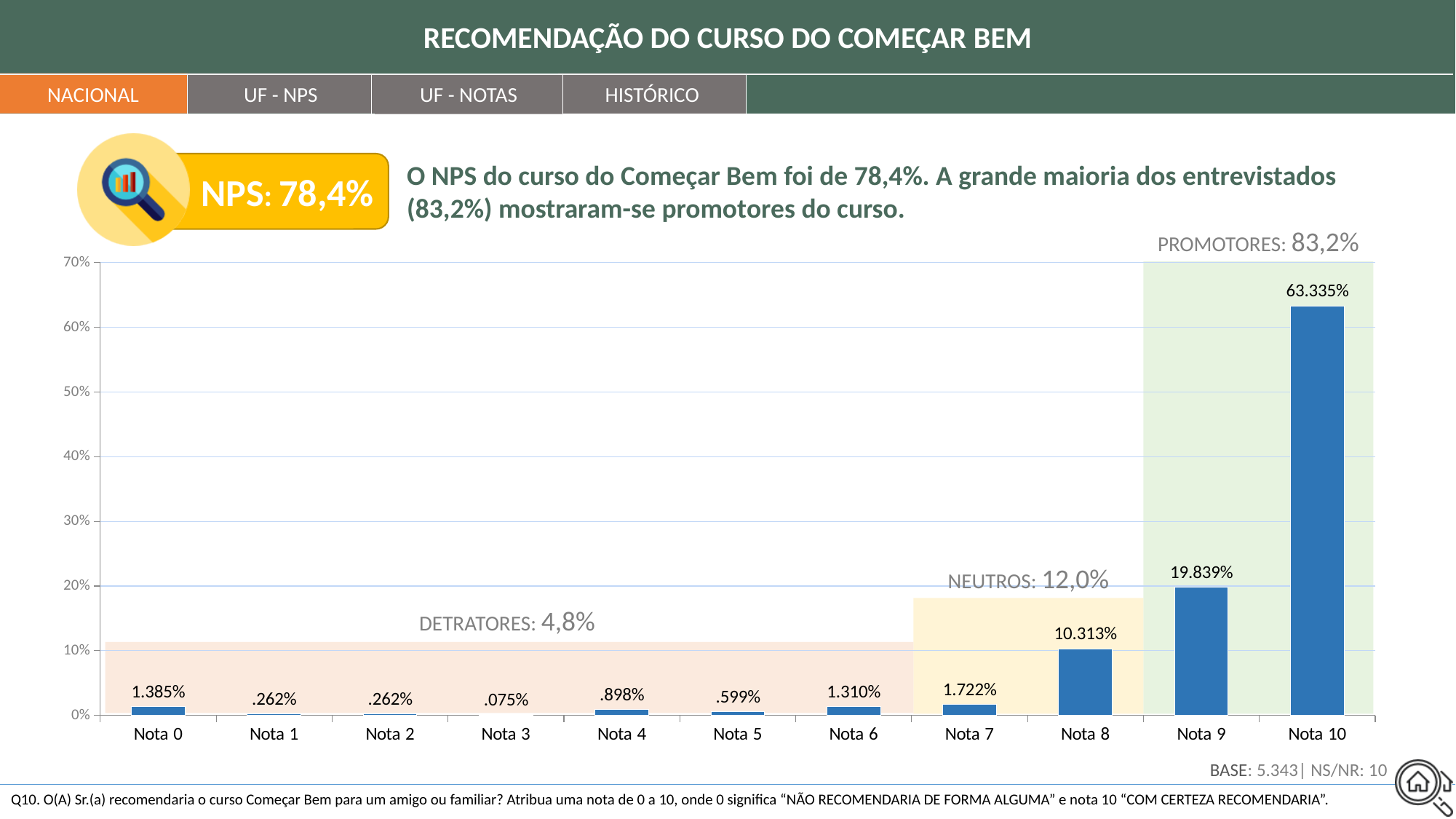
How many categories (notas) are shown on the x axis? 11 What is the difference between the values for Nota 10 and Nota 9? 43.496% What is the value for Nota 3? .075% Is the value for Nota 10 greater or less than 60%? greater What share of respondents is labelled as PROMOTORES on the chart? 83,2% Which category has the highest value? Nota 10 What is the value for Nota 8? 10.313% What is the value for Nota 10? 63.335% Do the values rise or fall from Nota 7 to Nota 10? rise Which is larger, the value for Nota 8 or the value for Nota 7? Nota 8 Which category has the lowest value? Nota 3 What kind of chart is shown on the slide? bar chart